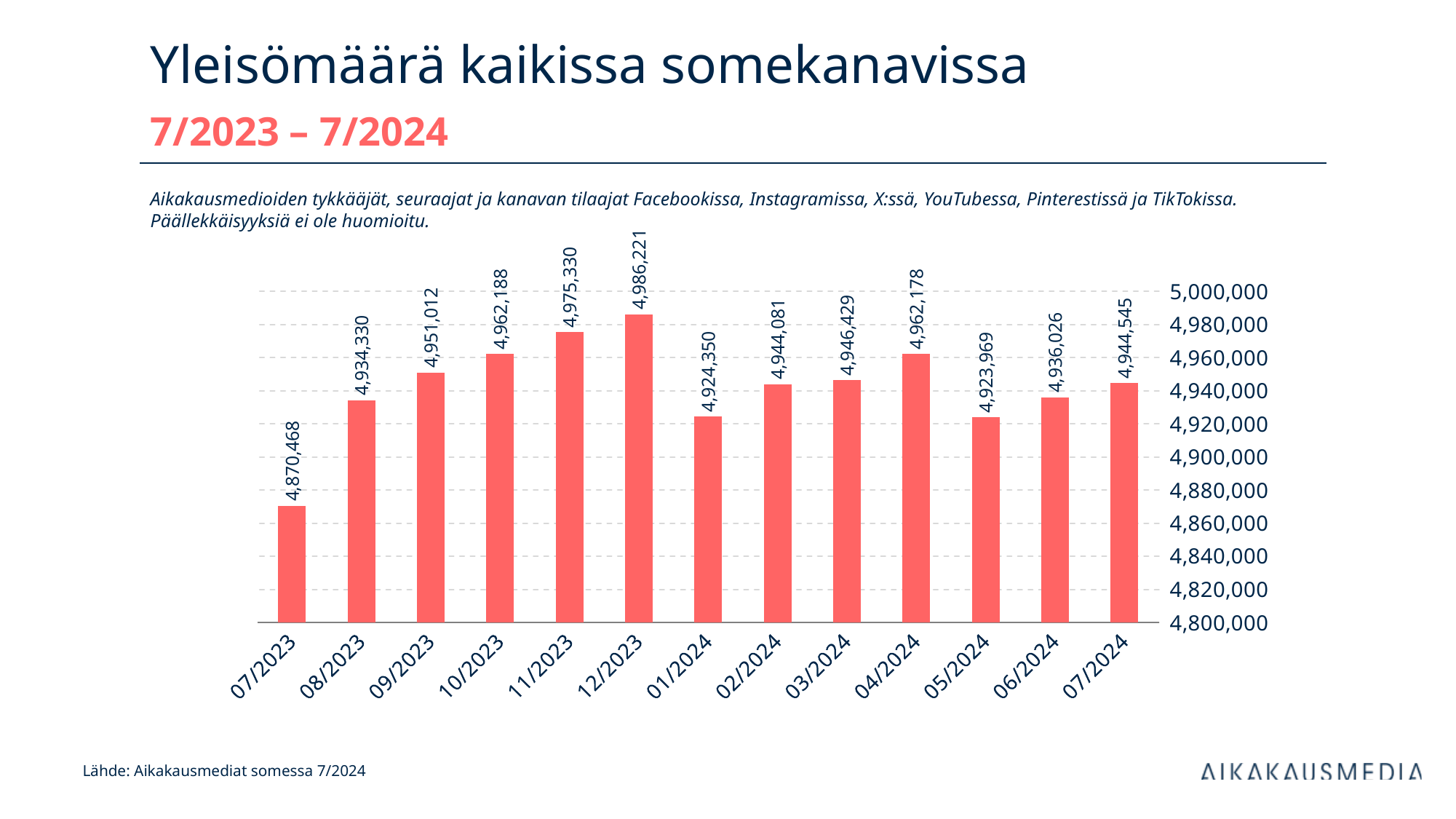
What is the difference between the values for 07/2024 and 07/2023? 74,077 Is the value for 05/2024 greater or less than 4,940,000? less What is the value for 12/2023? 4,986,221 How many months are shown on the x axis? 13 What kind of chart is shown on the slide? bar chart Which month has the highest value? 12/2023 What is the value for 03/2024? 4,946,429 What is the difference between the values for 12/2023 and 07/2023? 115,753 Which month has the lowest value? 07/2023 Which is larger, the value for 11/2023 or the value for 02/2024? 11/2023 Do the values rise or fall from 07/2023 to 12/2023? rise What is the value for 07/2023? 4,870,468